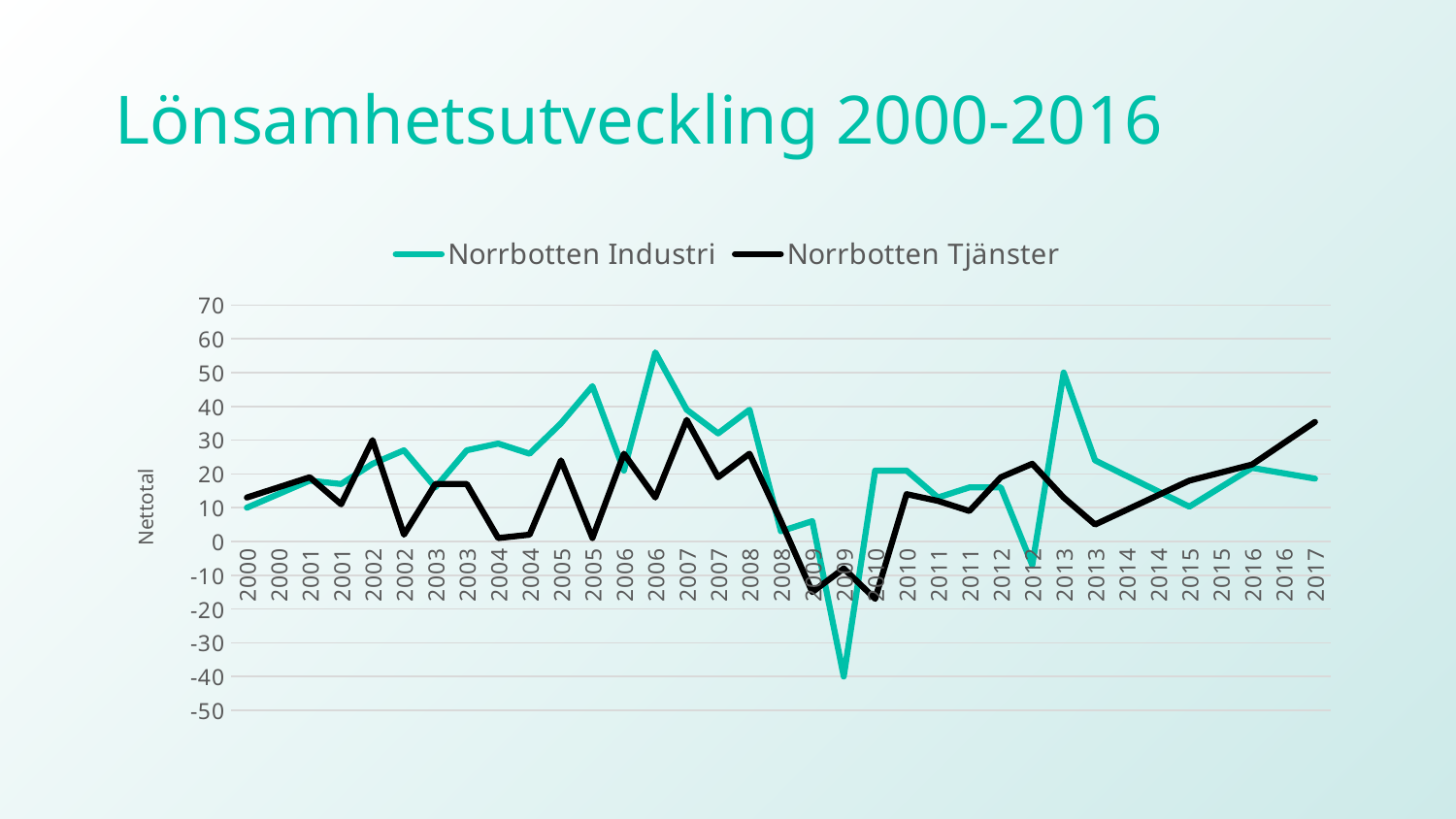
At the 2006 peak, which series has the higher value, Norrbotten Industri or Norrbotten Tjänster? Norrbotten Industri What is the label on the vertical axis? Nettotal What are the two series named in the legend? Norrbotten Industri and Norrbotten Tjänster At 2017, which series has the higher value, Norrbotten Industri or Norrbotten Tjänster? Norrbotten Tjänster Which series reaches the lowest value anywhere on the chart? Norrbotten Industri Which series reaches the highest value anywhere on the chart? Norrbotten Industri How many series does the legend list? 2 Is the value for Norrbotten Tjänster at 2017 greater or less than 30? greater Is the lowest value of Norrbotten Industri in 2009 greater or less than -30? less Is the peak value of Norrbotten Industri in 2006 greater or less than 50? greater What kind of chart is shown on the slide? Line chart Does the Norrbotten Tjänster line rise or fall from 2015 to 2017? rise